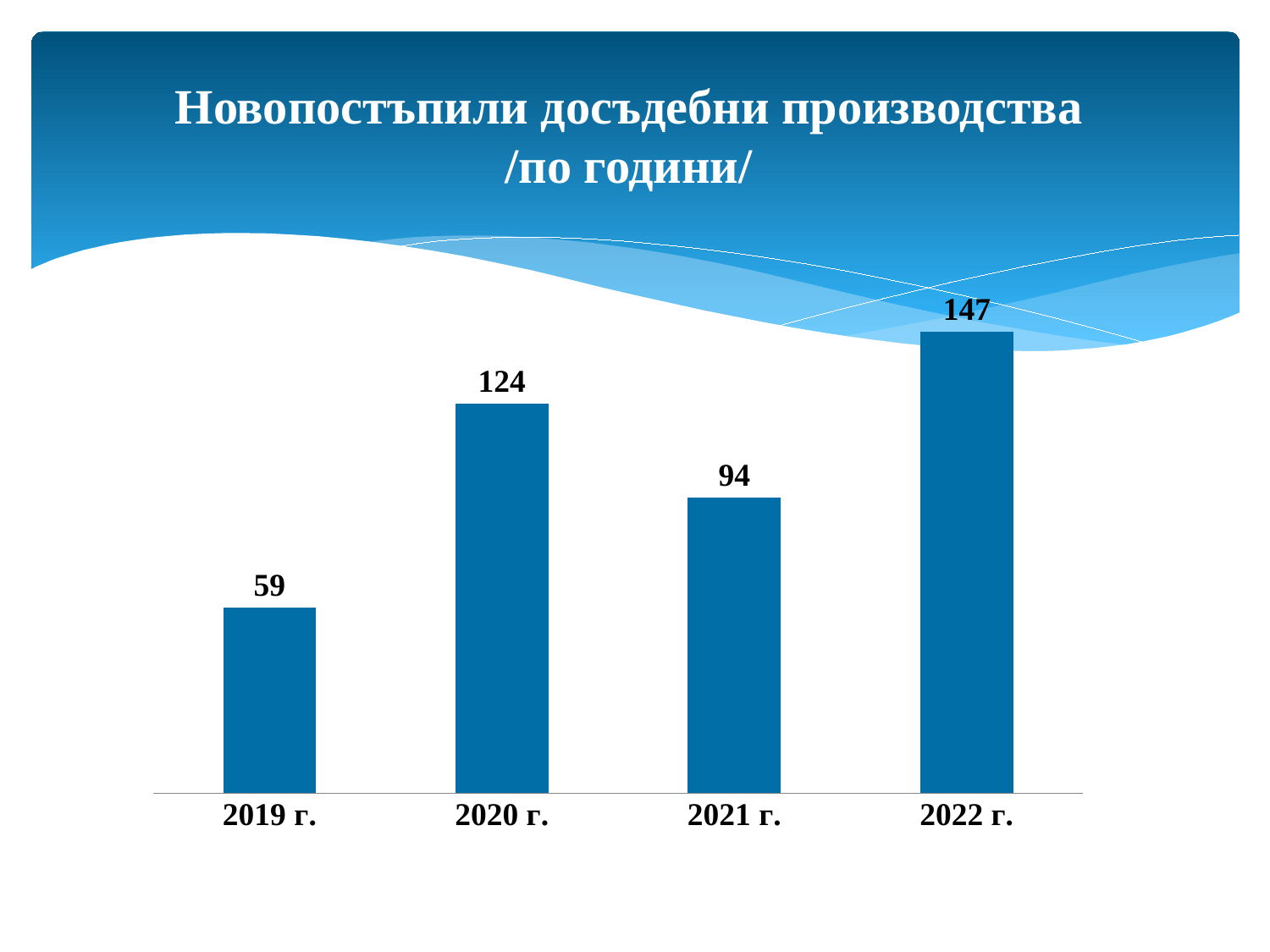
What is the value for 2021 г.? 94 What is the difference between the values for 2022 г. and 2019 г.? 88 Which year has the highest value? 2022 г. What is the title of the chart? Новопостъпили досъдебни производства /по години/ What is the value for 2020 г.? 124 Which year has the lowest value? 2019 г. What kind of chart is shown on the slide? Bar chart Which is larger, the value for 2020 г. or the value for 2021 г.? 2020 г. What is the difference between the values for 2020 г. and 2021 г.? 30 How many years are shown on the chart? 4 What is the value for 2022 г.? 147 What is the value for 2019 г.? 59